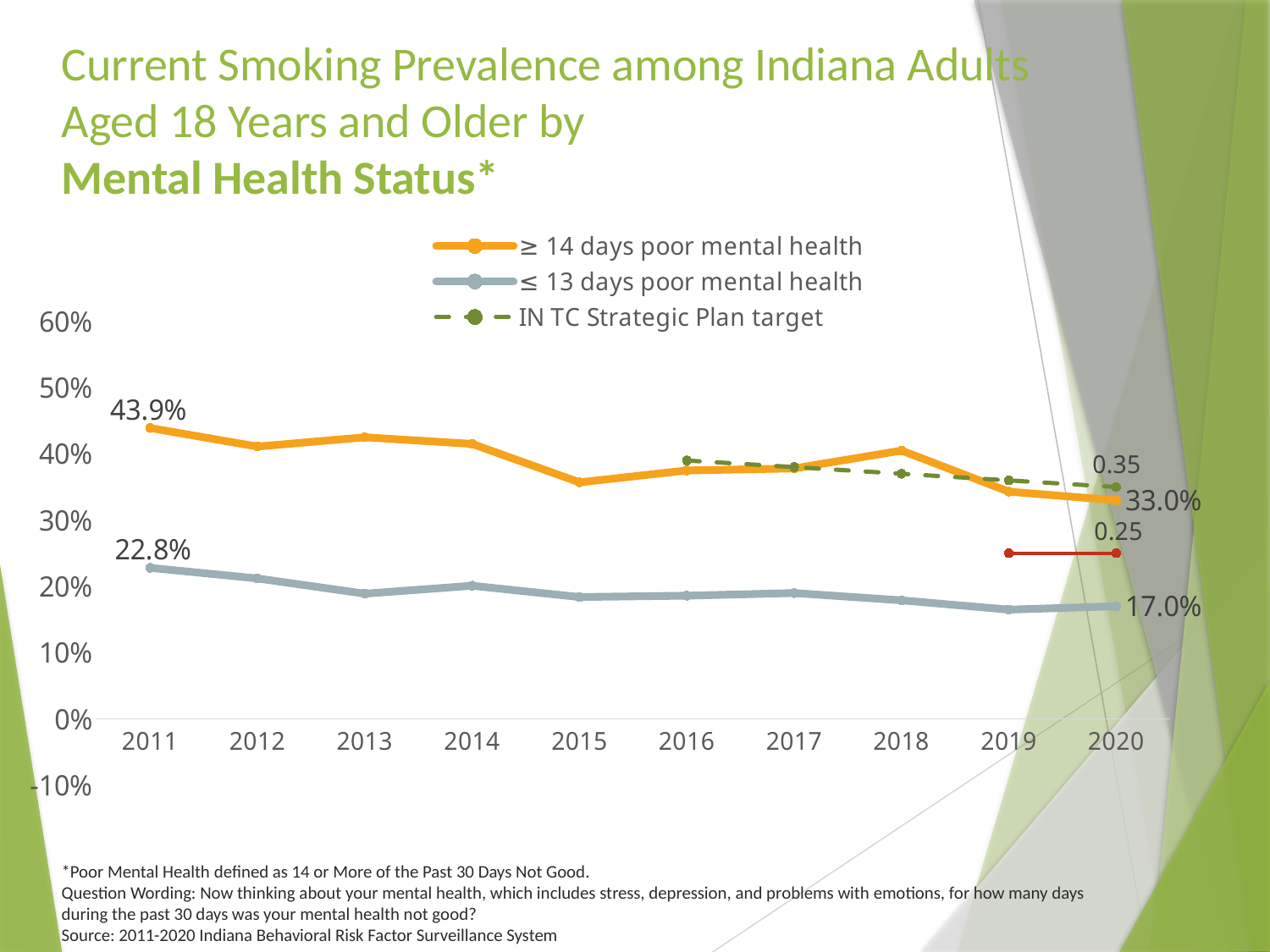
What is the labeled value of the IN TC Strategic Plan target line in 2020? 0.35 What is the value for the "≥ 14 days poor mental health" series in 2011? 43.9% What is the value for the "≥ 14 days poor mental health" series in 2020? 33.0% Is the value for "≥ 14 days poor mental health" in 2015 greater or less than 40%? less How many series does the legend list? 3 What is the difference between the "≥ 14 days" and "≤ 13 days" values in 2011? 21.1 percentage points By how much did the "≥ 14 days poor mental health" value fall from 2011 to 2020? 10.9 percentage points In 2020, which series has the higher value: "≥ 14 days poor mental health" or "≤ 13 days poor mental health"? ≥ 14 days poor mental health What is the value for the "≤ 13 days poor mental health" series in 2011? 22.8% What kind of chart is shown on the slide? line chart What is the value for the "≤ 13 days poor mental health" series in 2020? 17.0% How many years are shown on the x axis? 10